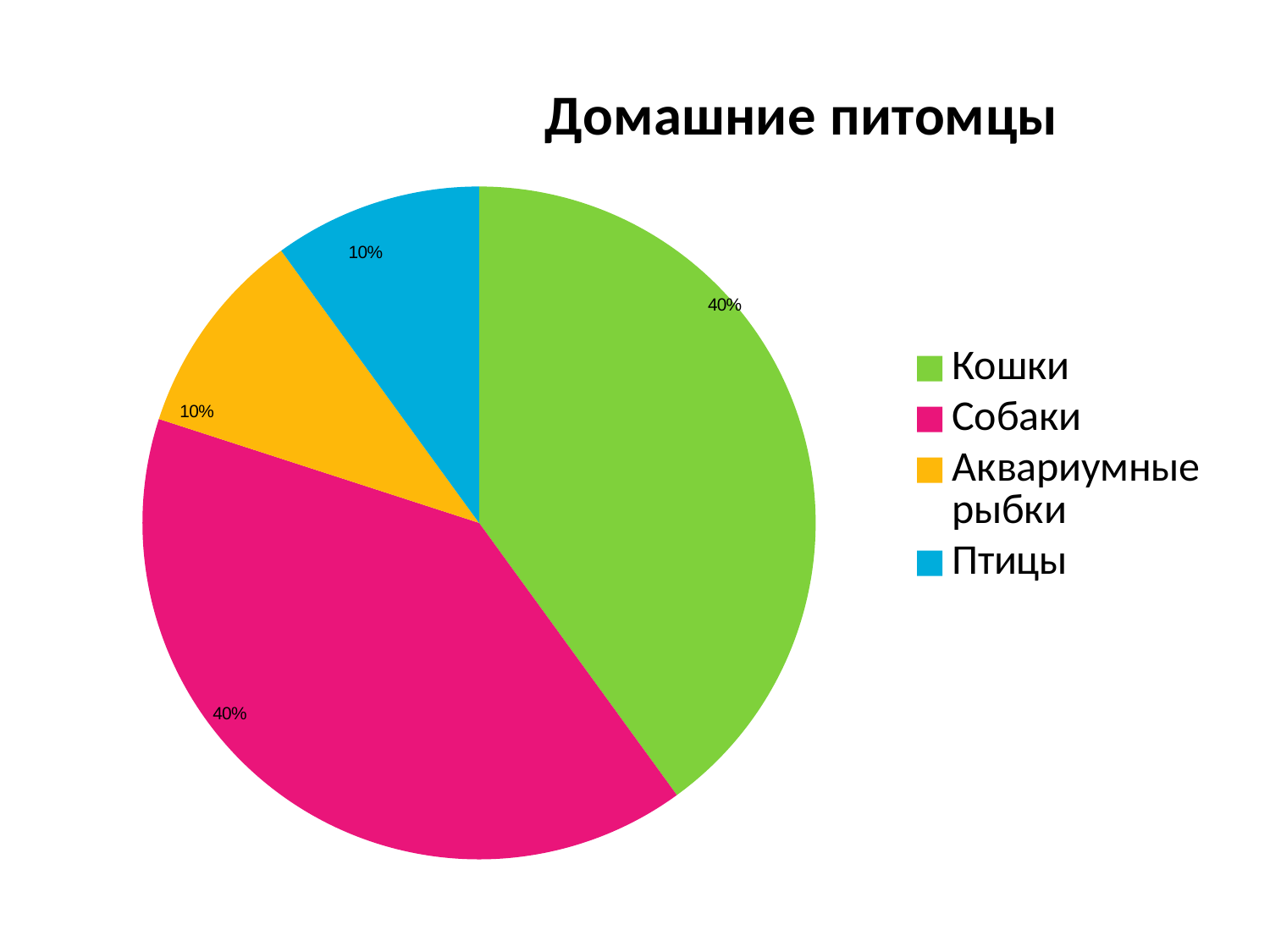
Which is larger, the share for Аквариумные рыбки or the share for Собаки? Собаки What colour is the slice for Птицы? blue How many categories does the pie chart show? 4 Which is larger, the share for Кошки or the share for Птицы? Кошки What is the difference between the share for Собаки and the share for Аквариумные рыбки? 30% What type of chart is shown on the slide? pie chart What is the title of the chart? Домашние питомцы What share of the pie does Кошки have? 40% What share of the pie does Аквариумные рыбки have? 10% What share of the pie does Собаки have? 40% What share of the pie does Птицы have? 10% What is the combined share of Кошки and Собаки? 80%